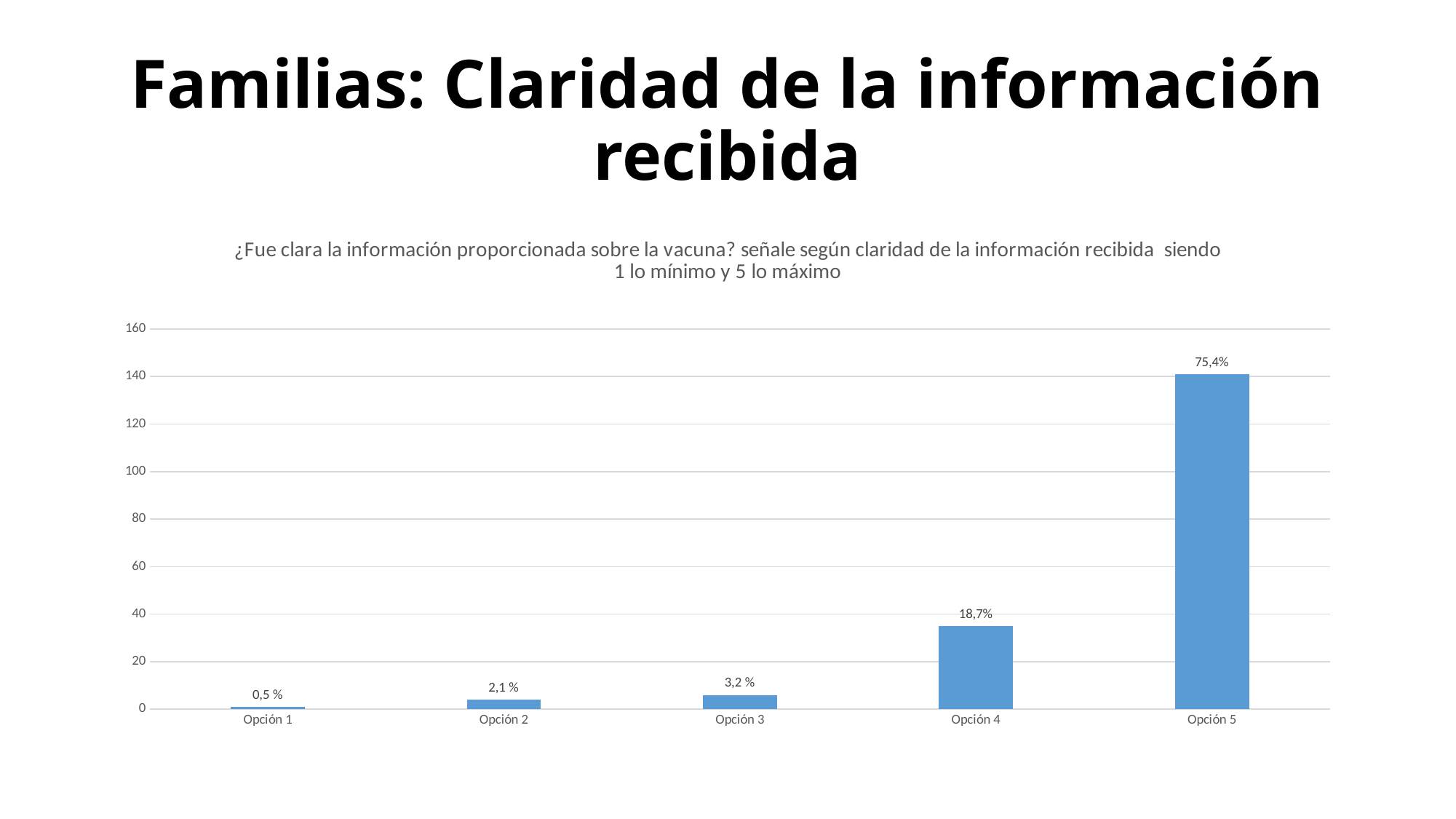
Which option has the lowest bar? Opción 1 What is the data label shown on the bar for Opción 5? 75,4% How many options (categories) are shown on the x axis? 5 Is the value for Opción 4 greater or less than 40 on the vertical axis? less Which bar is taller, Opción 4 or Opción 3? Opción 4 What kind of chart is shown on the slide? Bar chart What is the data label shown on the bar for Opción 1? 0,5 % What is the data label shown on the bar for Opción 3? 3,2 % Which option has the highest bar? Opción 5 Is the value for Opción 5 greater or less than 120 on the vertical axis? greater What is the data label shown on the bar for Opción 4? 18,7% Do the bar values rise or fall from Opción 1 to Opción 5? Rise